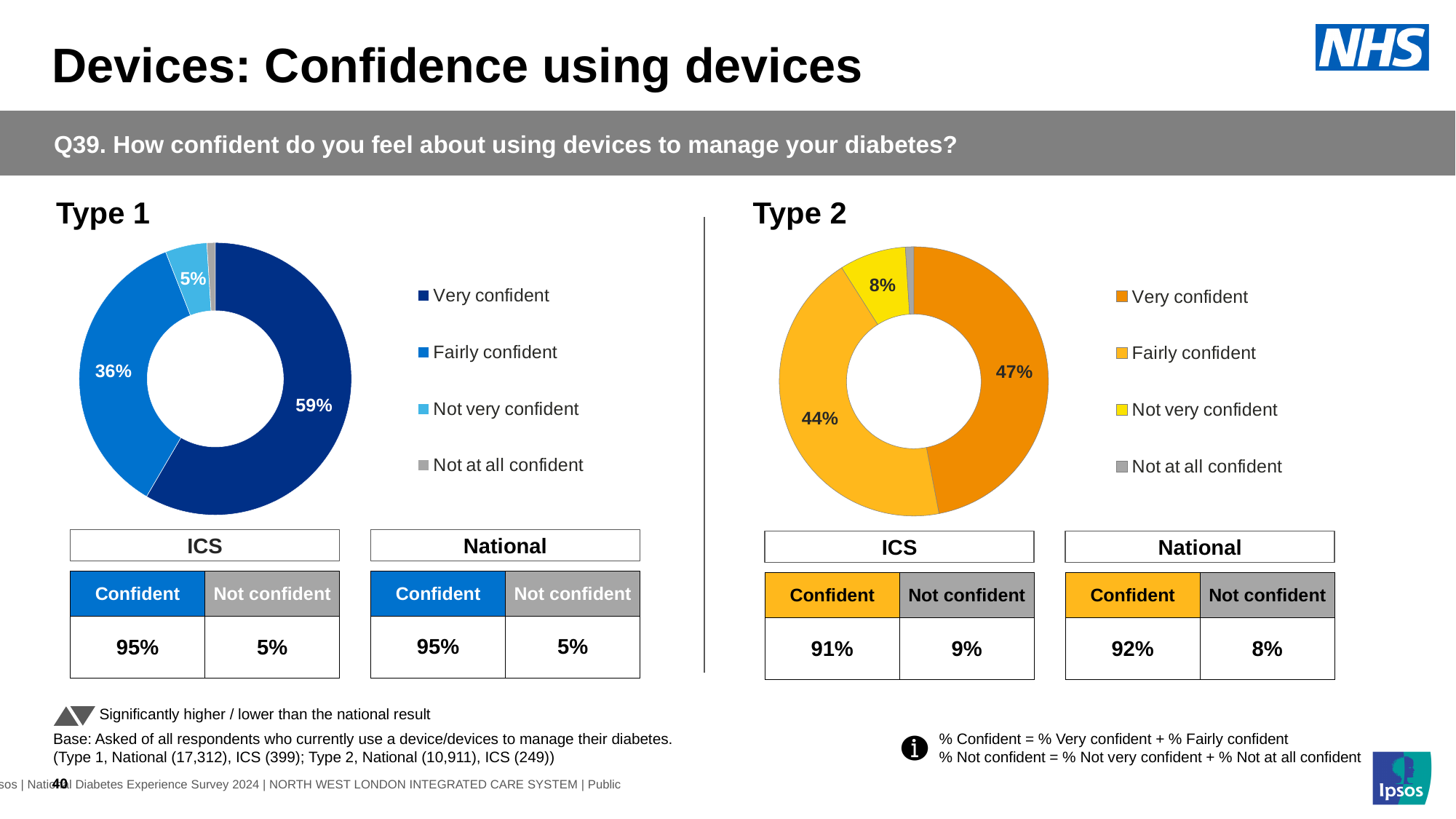
In the Type 1 chart, what percentage of respondents are very confident? 59% In the Type 1 chart, which category has the largest share? Very confident In the Type 1 chart, what is the difference between the very confident and fairly confident shares? 23 percentage points In the Type 1 chart, what percentage of respondents are fairly confident? 36% In the Type 2 chart, what percentage of respondents are not very confident? 8% In the Type 2 chart, what is the difference between the very confident and fairly confident shares? 3 percentage points In the Type 2 chart, what colour represents the fairly confident category? Yellow-orange In the Type 2 chart, which category has the largest share? Very confident How many categories does the legend of the Type 2 chart list? 4 What type of chart is used for Type 1? Donut chart In the Type 2 chart, what percentage of respondents are very confident? 47% Is the very confident share larger in the Type 1 chart or the Type 2 chart? Type 1